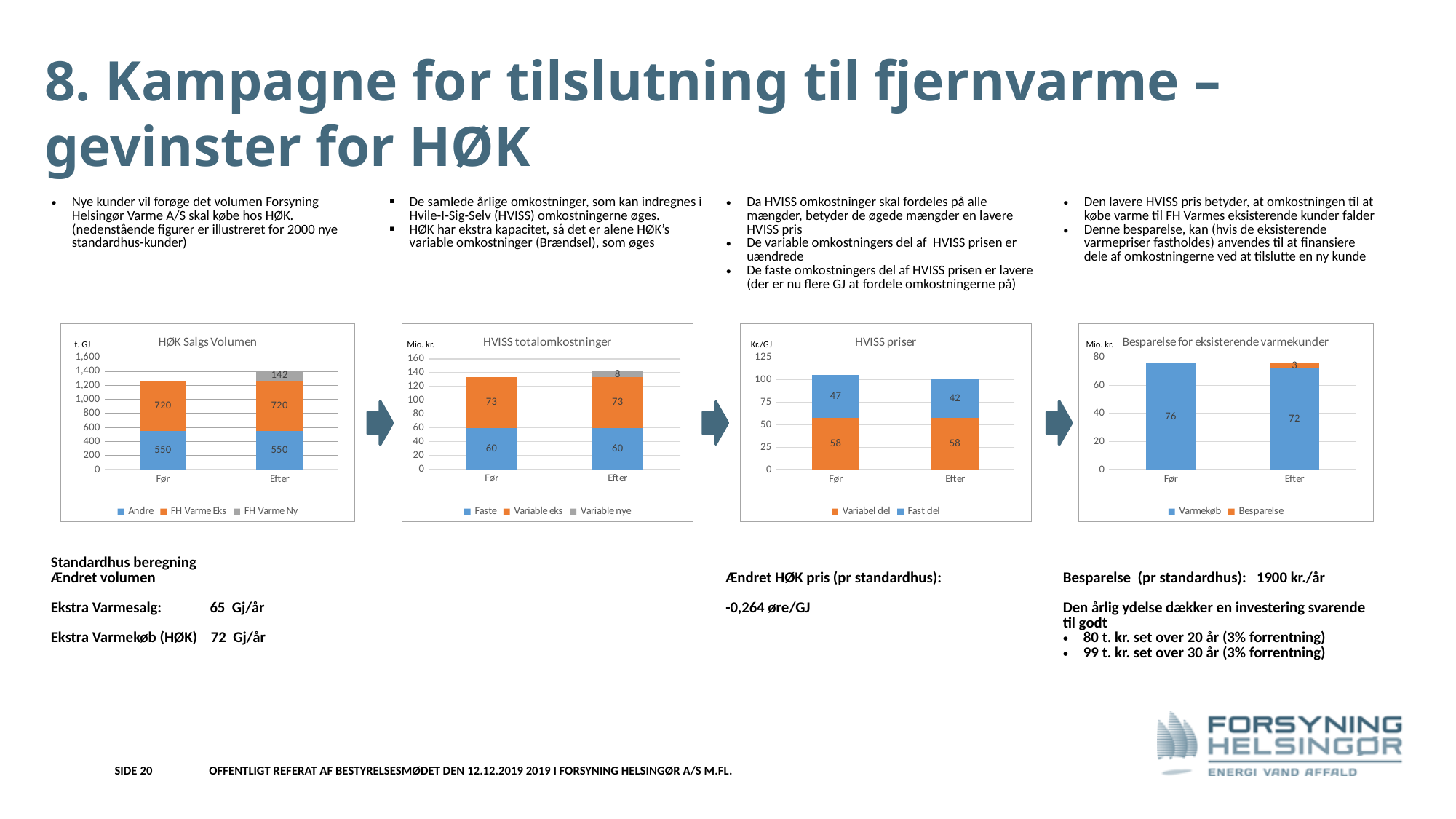
In the Besparelse for eksisterende varmekunder chart, what unit is shown on the y axis? Mio. kr. In the Besparelse for eksisterende varmekunder chart, what is the difference between Varmekøb for Før and Varmekøb for Efter? 4 In the HØK Salgs Volumen chart, how many series does the legend list? 3 In the HVISS totalomkostninger chart, what is the value of Variable nye for Efter? 8 In the Besparelse for eksisterende varmekunder chart, what is the value of Varmekøb for Efter? 72 In the HVISS priser chart, what is the difference between Fast del for Før and Fast del for Efter? 5 In the HVISS priser chart, which is larger for Før: Variabel del or Fast del? Variabel del In the HVISS totalomkostninger chart, what kind of chart is shown? Stacked bar chart In the HØK Salgs Volumen chart, what is the value of FH Varme Ny for Efter? 142 In the HØK Salgs Volumen chart, what is the total of the stacked bar for Efter? 1,412 In the HVISS totalomkostninger chart, what is the total of the stacked bar for Før? 133 In the HVISS priser chart, what is the value of Fast del for Efter? 42